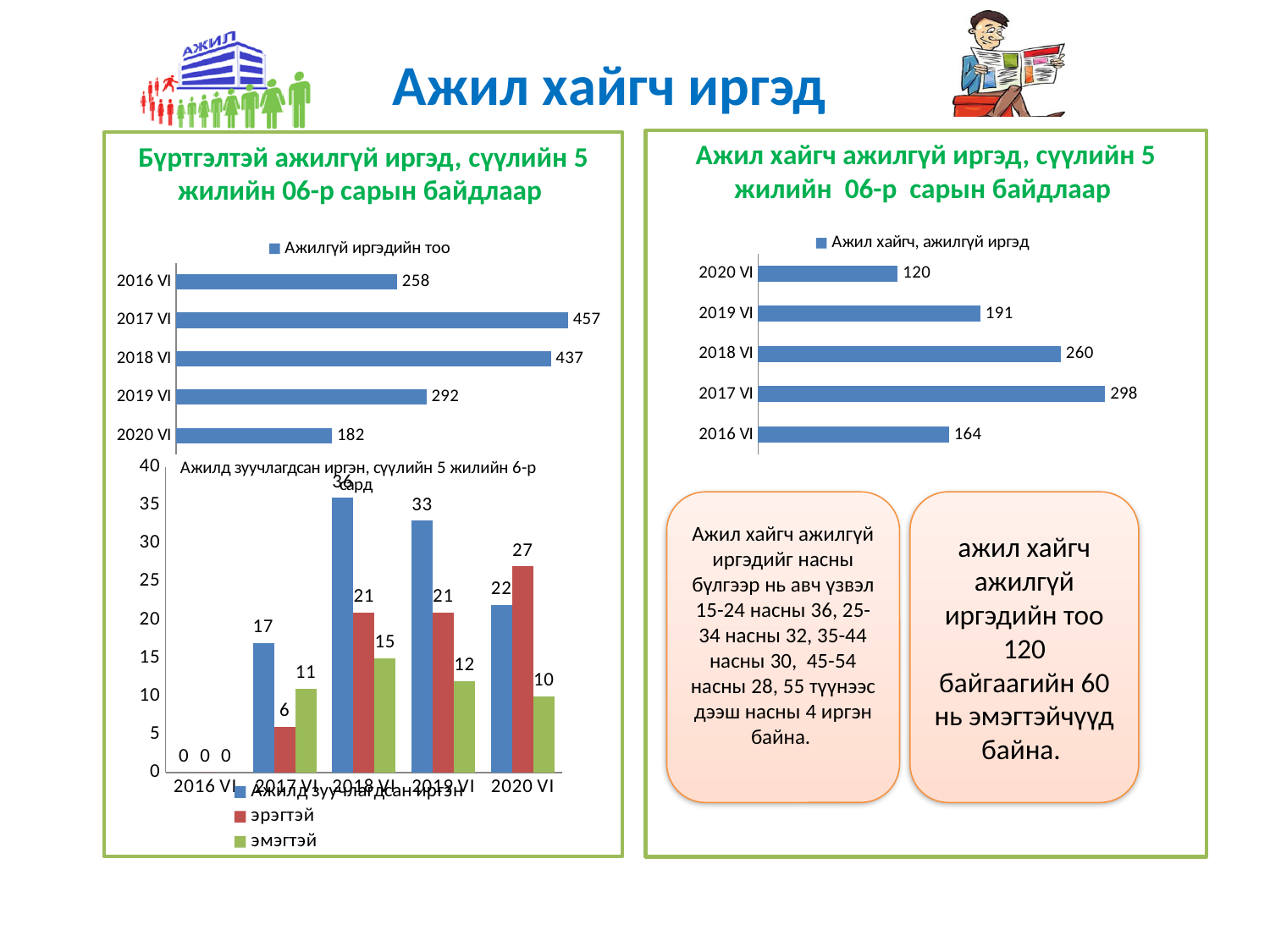
In the right-hand chart 'Ажил хайгч, ажилгүй иргэд', which is larger: the value for 2016 VI or 2019 VI? 2019 VI In the top-left chart 'Ажилгүй иргэдийн тоо', what is the difference between the values for 2018 VI and 2019 VI? 145 In the bottom-left chart 'Ажилд зуучлагдсан иргэн', which year has the highest value for the 'Ажилд зуучлагдсан иргэн' series? 2018 VI In the bottom-left chart 'Ажилд зуучлагдсан иргэн', what is the value of the 'эмэгтэй' series for 2017 VI? 11 In the right-hand chart 'Ажил хайгч, ажилгүй иргэд', which year has the highest value? 2017 VI How many series does the legend of the bottom-left chart 'Ажилд зуучлагдсан иргэн' list? 3 What kind of chart is the right-hand chart 'Ажил хайгч, ажилгүй иргэд'? Bar chart In the right-hand chart 'Ажил хайгч, ажилгүй иргэд', what is the value for 2018 VI? 260 In the bottom-left chart 'Ажилд зуучлагдсан иргэн', what is the value of the 'эрэгтэй' series for 2018 VI? 21 How many categories are shown in the top-left chart 'Ажилгүй иргэдийн тоо'? 5 In the top-left chart 'Ажилгүй иргэдийн тоо', what is the value for 2017 VI? 457 In the top-left chart 'Ажилгүй иргэдийн тоо', which year has the lowest value? 2020 VI